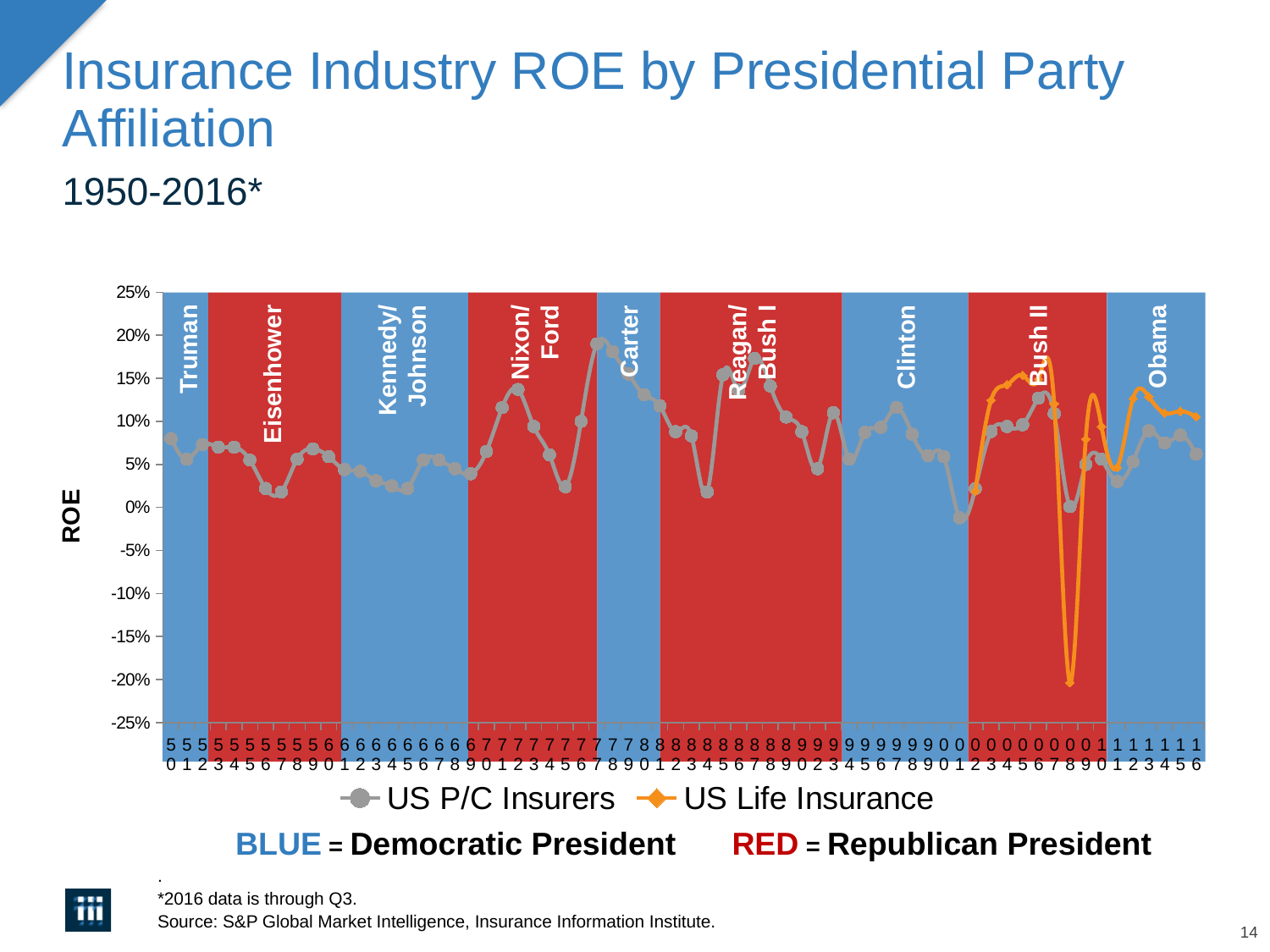
In 2008, which series has the larger value, US P/C Insurers or US Life Insurance? US P/C Insurers Is the value for US Life Insurance in 2008 greater or less than -15%? less Does the US Life Insurance line rise or fall from 2008 to 2009? rise What kind of chart is shown on the slide? line chart How many series does the legend list? 2 Is the value for US P/C Insurers in 1957 greater or less than 5%? less What are the two series named in the legend? US P/C Insurers and US Life Insurance In which year does US Life Insurance reach its lowest value? 2008 Is the value for US P/C Insurers in 1977 greater or less than 15%? greater Which series reaches the lowest value on the chart? US Life Insurance According to the slide, what does a blue background indicate? Democratic President